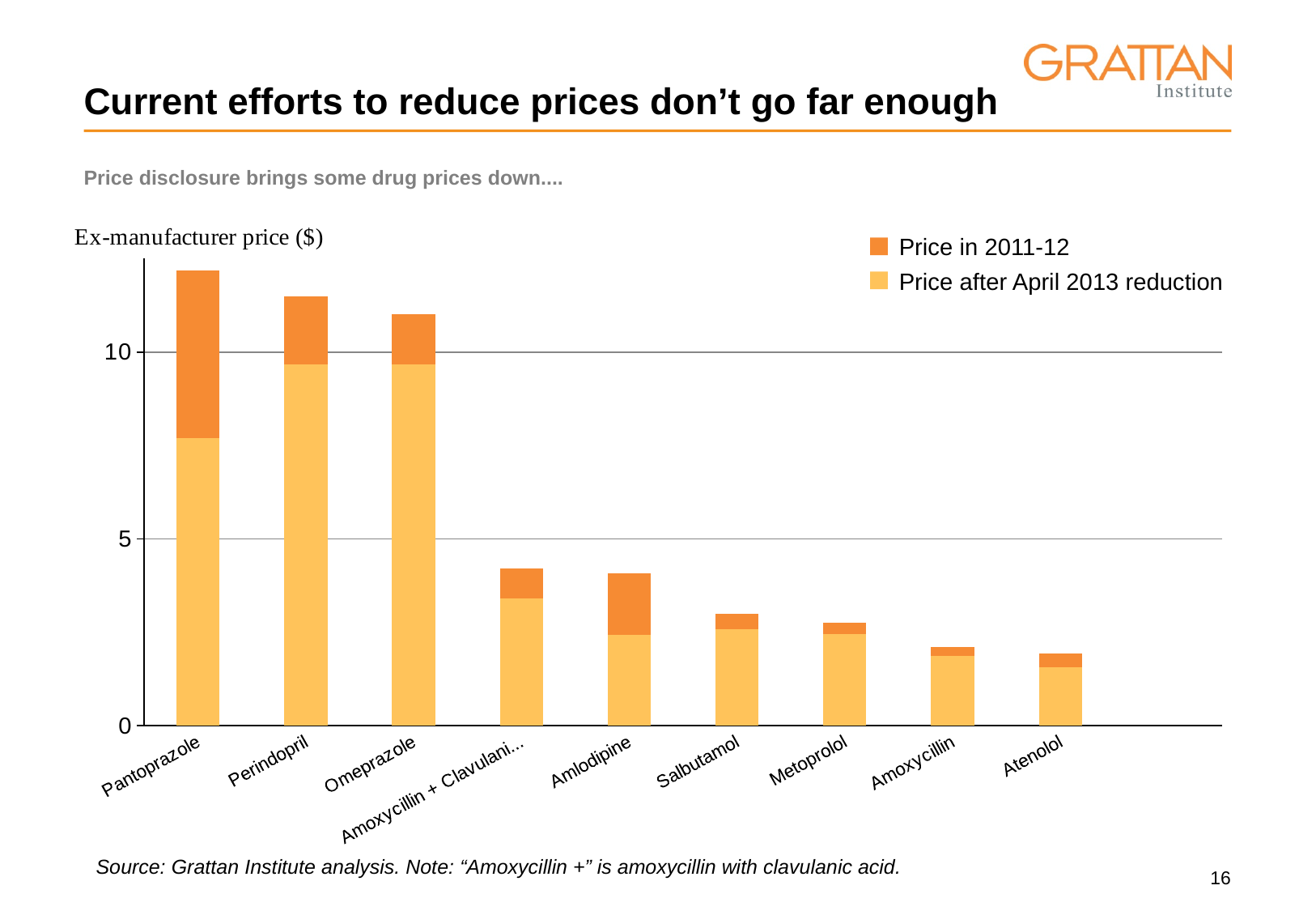
Is the price in 2011-12 for Omeprazole greater or less than 10? greater Do the drug prices rise or fall moving from left to right along the x axis? Fall Which has the higher price in 2011-12, Amlodipine or Salbutamol? Amlodipine Which drug has the lowest price after the April 2013 reduction? Atenolol Is the price in 2011-12 for Amlodipine greater or less than 5? less What kind of chart is shown on the slide? Bar chart What is the label on the vertical axis of the chart? Ex-manufacturer price ($) How many series does the chart's legend list? 2 Is the price in 2011-12 for Pantoprazole greater or less than 10? greater How many drugs are shown on the x axis of the chart? 9 Which drug has the highest price in 2011-12? Pantoprazole